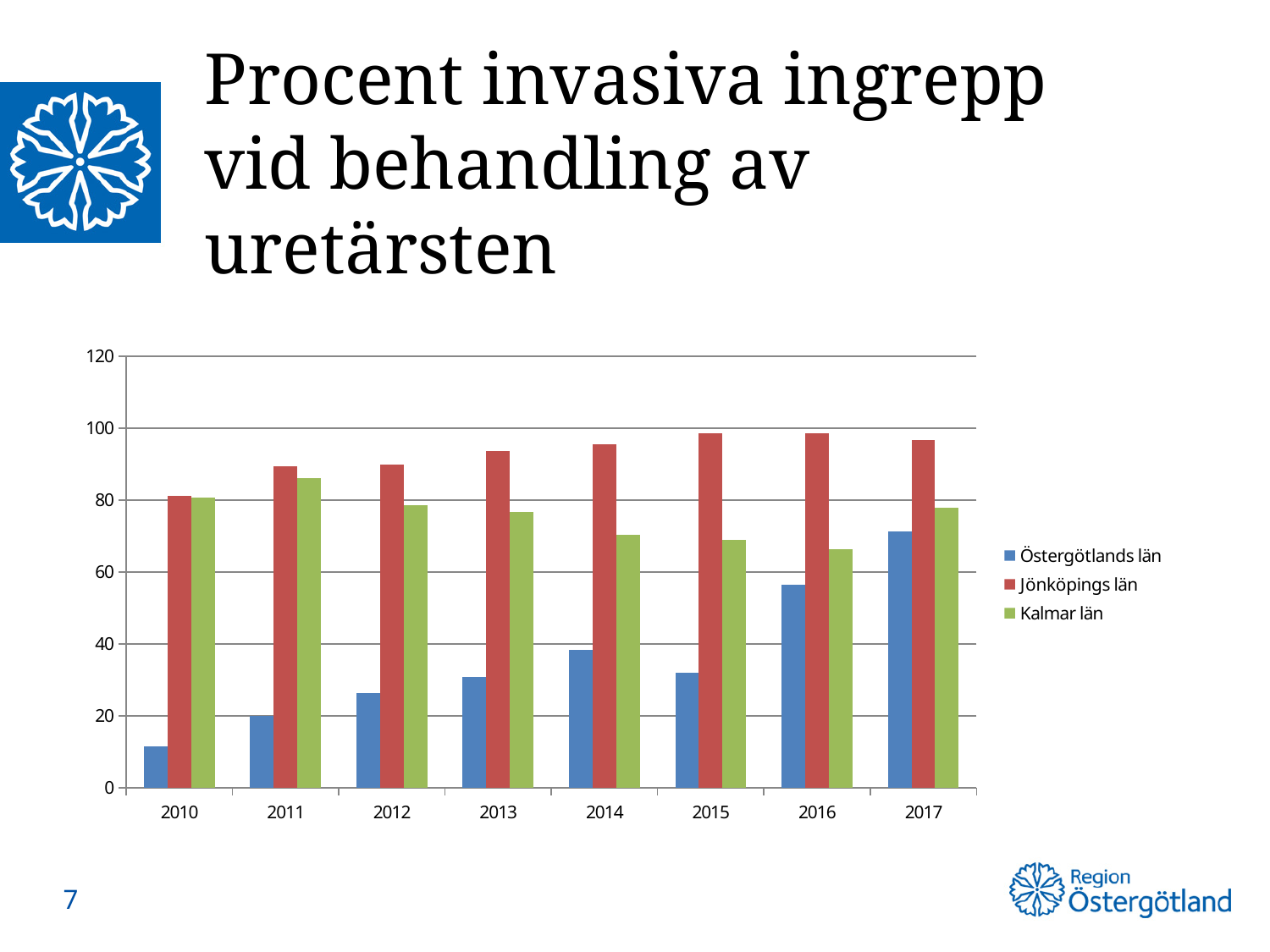
Which series is shown in red in the legend? Jönköpings län How many series does the legend list? 3 How many years are shown on the x axis? 8 Is the value for Kalmar län in 2016 greater or less than 80? less Do the values for Östergötlands län generally rise or fall from 2010 to 2017? rise What kind of chart is shown on the slide? Bar chart In which year is the value for Kalmar län highest? 2011 Is the value for Östergötlands län in 2016 greater or less than 40? greater Is the value for Östergötlands län in 2010 greater or less than 20? less In which year is the value for Östergötlands län lowest? 2010 In which year is the value for Östergötlands län highest? 2017 In 2010, which is larger: the value for Jönköpings län or for Östergötlands län? Jönköpings län